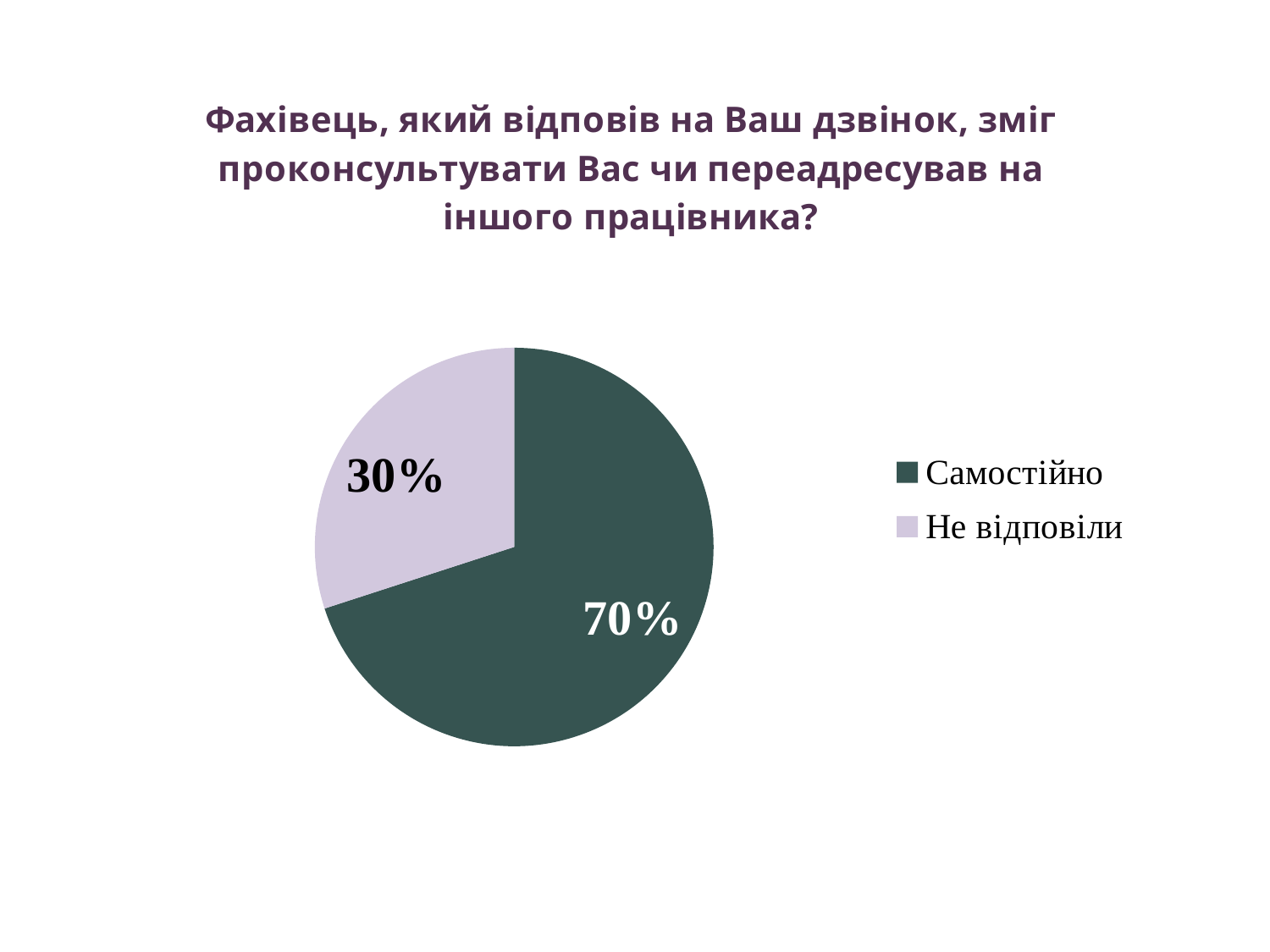
Which category has the smallest slice of the pie? Не відповіли Which category has the largest slice of the pie? Самостійно What share of the pie does "Самостійно" represent? 70% How many slices does the pie chart have? 2 What share of the pie does "Не відповіли" represent? 30% What colour is the slice for "Самостійно"? dark green What kind of chart is shown on the slide? pie chart What is the difference in percentage points between "Самостійно" and "Не відповіли"? 40 percentage points How many entries does the legend list? 2 Which is larger, the slice for "Самостійно" or the slice for "Не відповіли"? Самостійно Which legend entry is shown in light lavender? Не відповіли